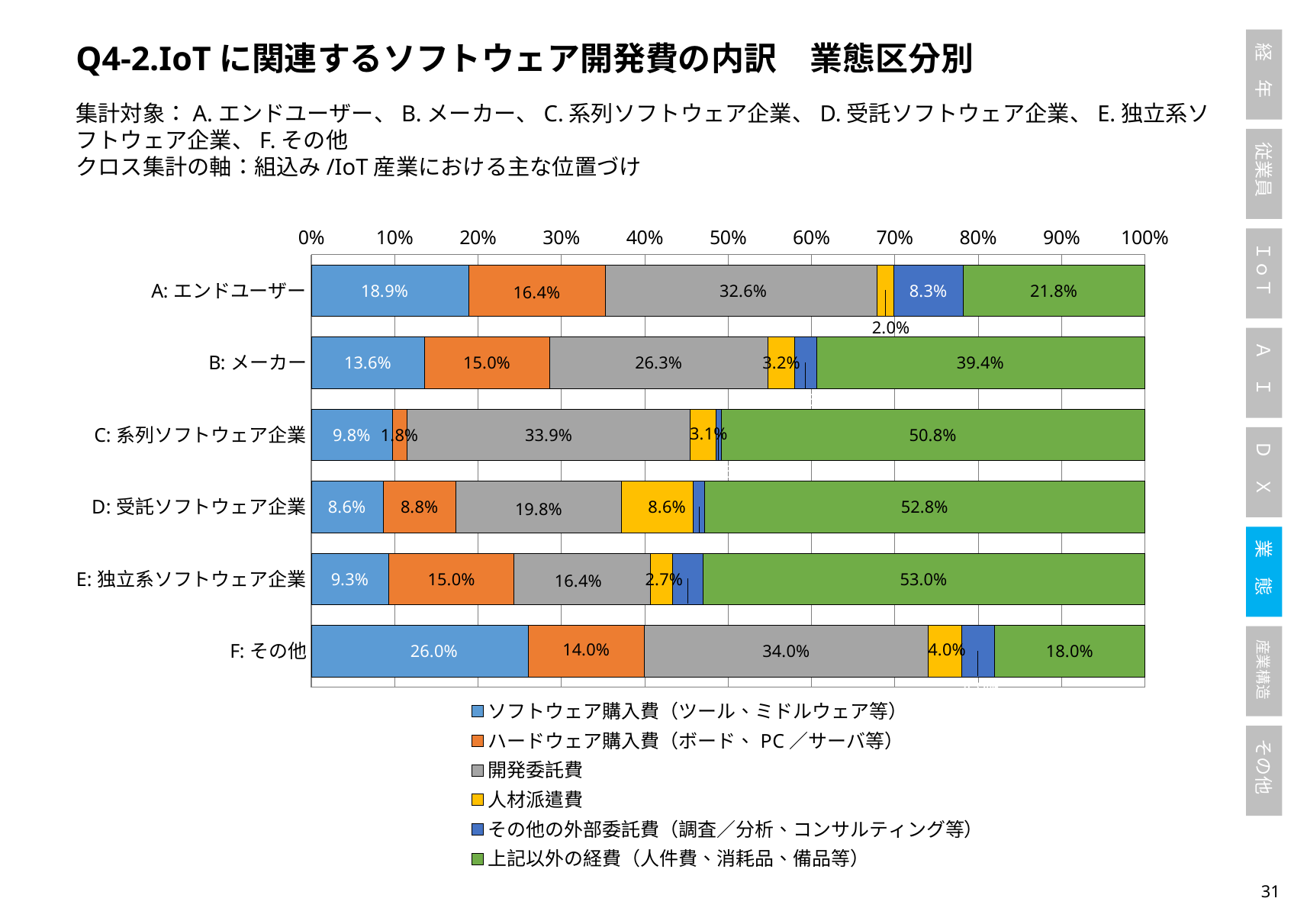
What is the value of ソフトウェア購入費（ツール、ミドルウェア等） for A: エンドユーザー? 18.9% Which category has the highest value for ソフトウェア購入費（ツール、ミドルウェア等）? F: その他 What is the value of 人材派遣費 for D: 受託ソフトウェア企業? 8.6% What colour represents 人材派遣費 in the chart? Yellow Which has the larger 開発委託費 value, F: その他 or C: 系列ソフトウェア企業? F: その他 How many categories are shown on the chart? 6 How many series does the legend list? 6 What is the difference in 開発委託費 between A: エンドユーザー and B: メーカー? 6.3 percentage points Which category has the lowest value for ハードウェア購入費（ボード、PC／サーバ等）? C: 系列ソフトウェア企業 What is the value of 上記以外の経費（人件費、消耗品、備品等） for D: 受託ソフトウェア企業? 52.8% What kind of chart is shown on the slide? Stacked horizontal bar chart Is the value of ソフトウェア購入費（ツール、ミドルウェア等） for F: その他 greater or less than 20%? greater